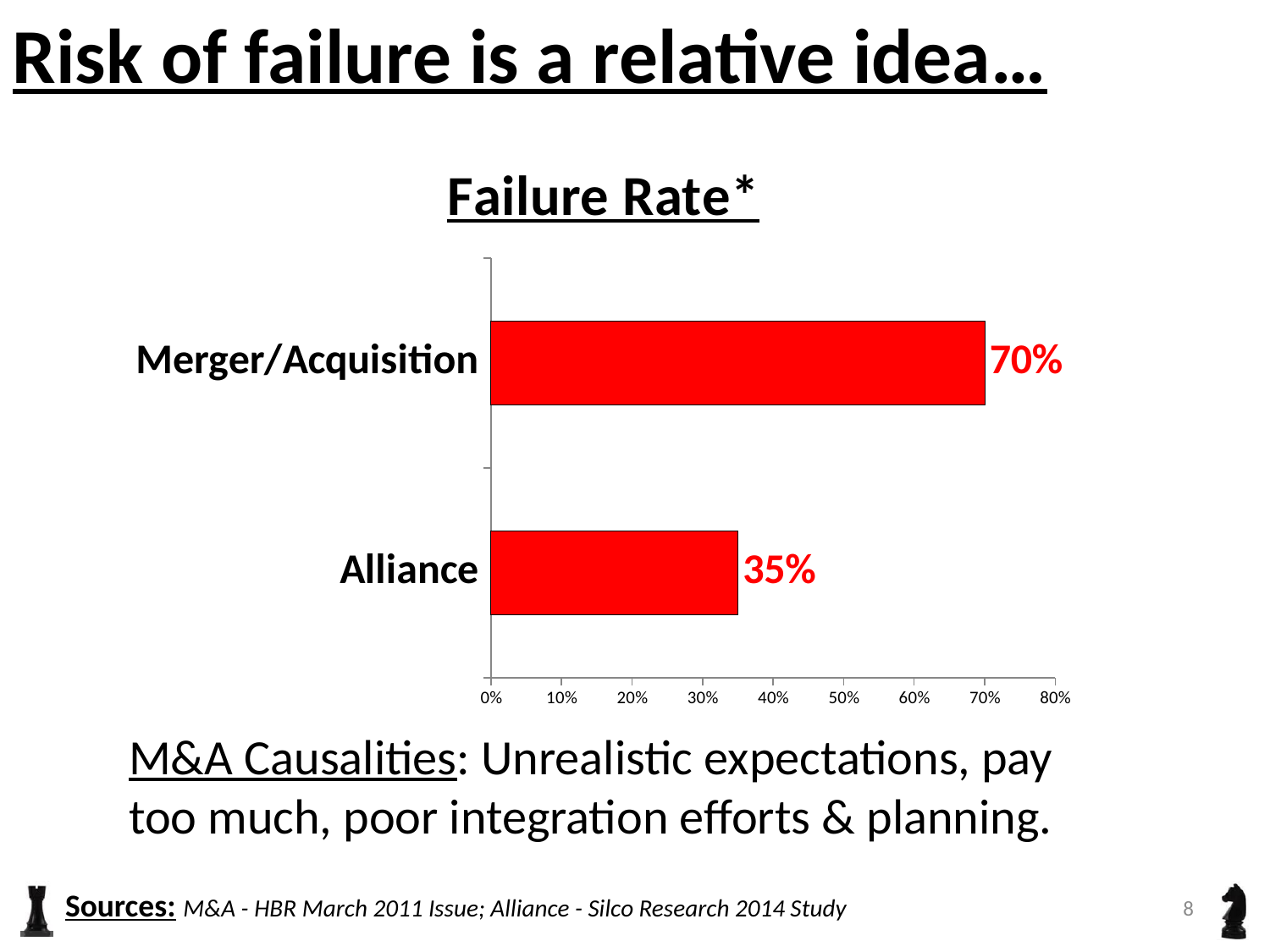
Which category has the highest failure rate? Merger/Acquisition What is the title of the chart? Failure Rate* Is the failure rate for Merger/Acquisition greater or less than 60%? greater What kind of chart is shown on the slide? Bar chart How many categories are shown in the chart? 2 Is the failure rate for Alliance greater or less than 40%? less Which has a larger failure rate, Alliance or Merger/Acquisition? Merger/Acquisition What is the difference between the failure rates for Merger/Acquisition and Alliance? 35% What is the failure rate for Alliance? 35% What is the failure rate for Merger/Acquisition? 70% Which category has the lowest failure rate? Alliance What is the maximum value shown on the chart's horizontal axis? 80%